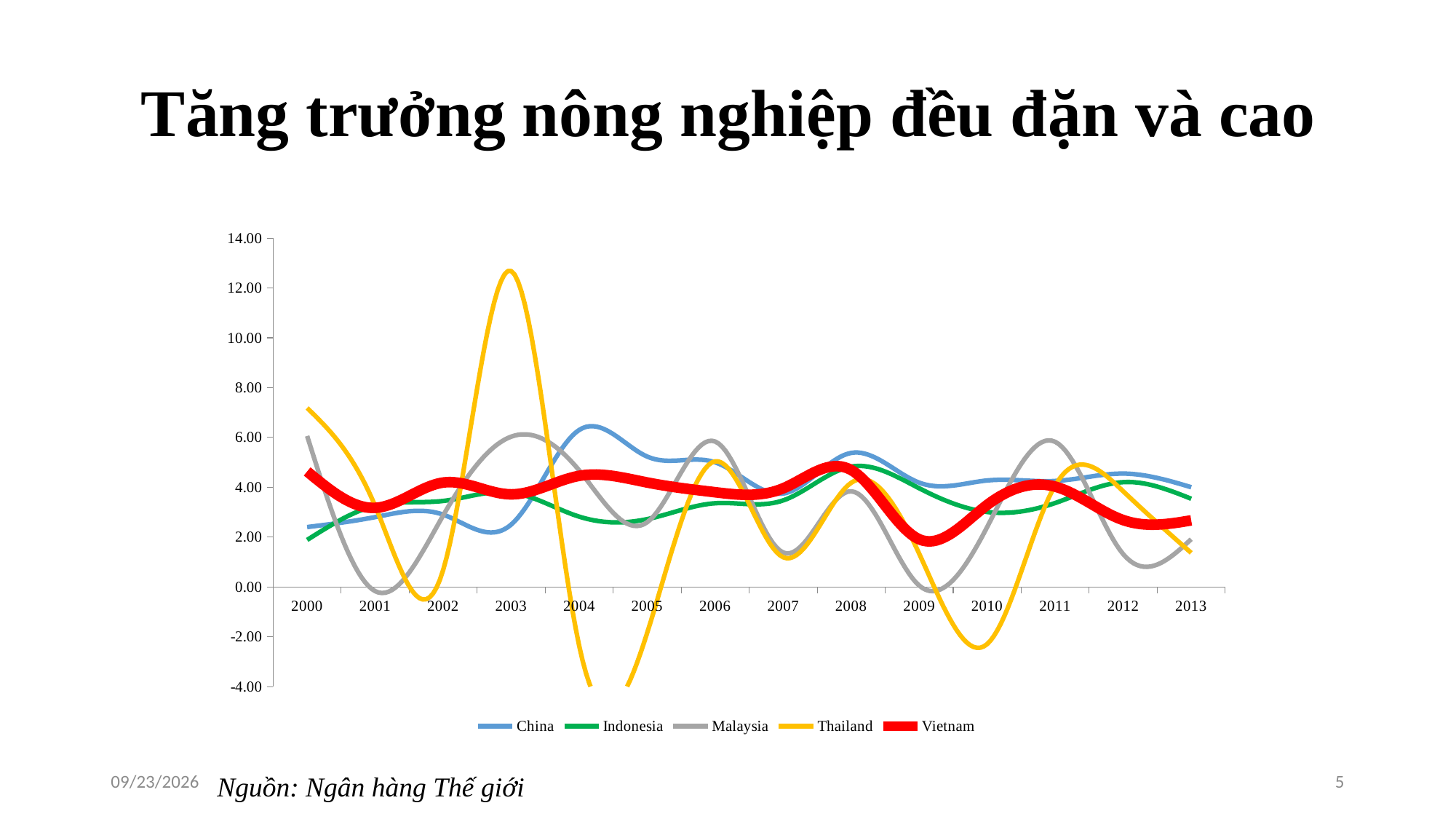
What kind of chart is shown on the slide? line chart In 2012, which is larger: the value for Vietnam or the value for Malaysia? Vietnam Which series has the lowest value in 2004? Thailand Is the value for China in 2004 greater or less than 6.00? greater Which series is drawn with the thick red line? Vietnam Is the value for Malaysia in 2012 greater or less than 2.00? less How many series does the legend list? 5 Which series has the highest value in 2003? Thailand How many years are shown on the x axis? 14 Is the value for Thailand in 2010 greater or less than 0.00? less Which series reaches the highest value anywhere on the chart? Thailand